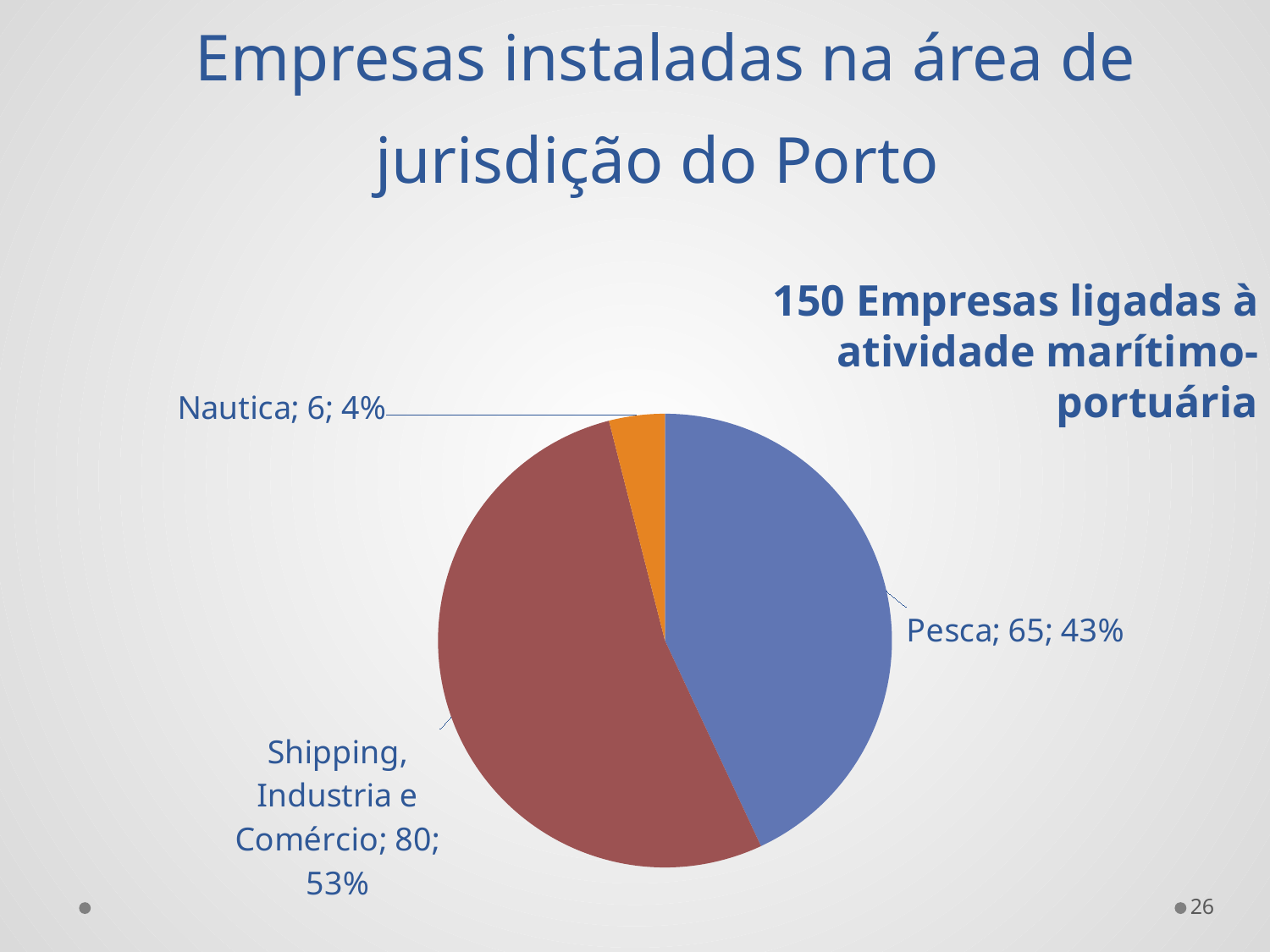
How many categories does the pie chart show? 3 What is the difference between the number of companies in Shipping, Industria e Comércio and in Pesca? 15 Which category has the smallest slice of the pie? Nautica What share of the pie does Pesca represent? 43% What kind of chart is shown on the slide? pie chart What share of the pie does Nautica represent? 4% How many companies are in the Nautica category? 6 Which category has the largest slice of the pie? Shipping, Industria e Comércio How many companies are in the Shipping, Industria e Comércio category? 80 Which has more companies, Pesca or Nautica? Pesca What is the title of the pie chart? 150 Empresas ligadas à atividade marítimo-portuária How many companies are in the Pesca category? 65